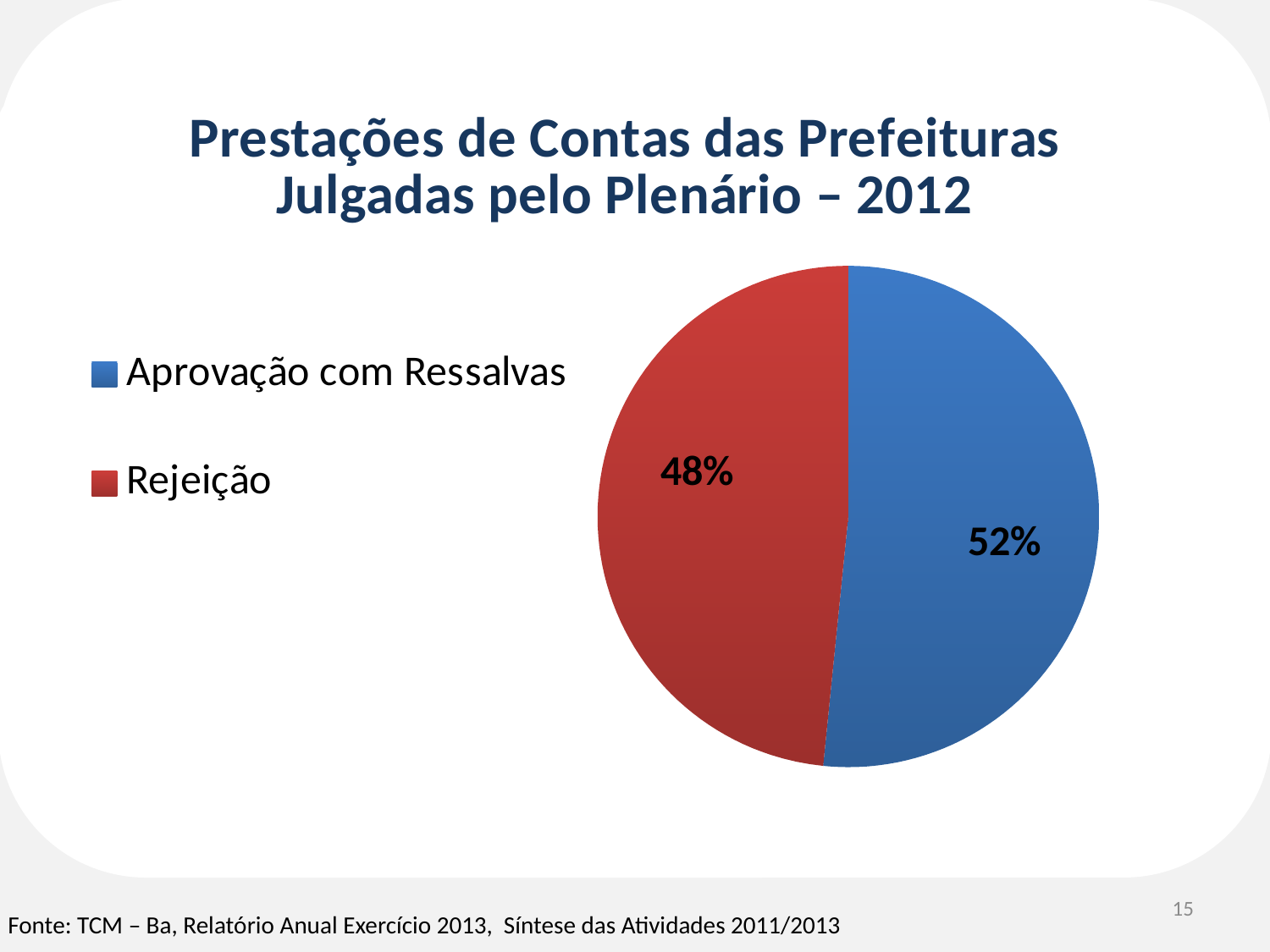
What share of the pie does Aprovação com Ressalvas represent? 52% Is the share for Aprovação com Ressalvas greater or less than 50%? greater What is the difference in percentage points between Aprovação com Ressalvas and Rejeição? 4 percentage points What share of the pie does Rejeição represent? 48% What is the title of the chart? Prestações de Contas das Prefeituras Julgadas pelo Plenário – 2012 Which colour represents Rejeição in the pie chart? Red Which is larger, the share for Aprovação com Ressalvas or the share for Rejeição? Aprovação com Ressalvas Which category has the smallest slice of the pie? Rejeição What kind of chart is shown on the slide? Pie chart Is the share for Rejeição greater or less than 50%? less Which category has the largest slice of the pie? Aprovação com Ressalvas How many categories does the pie chart show? 2